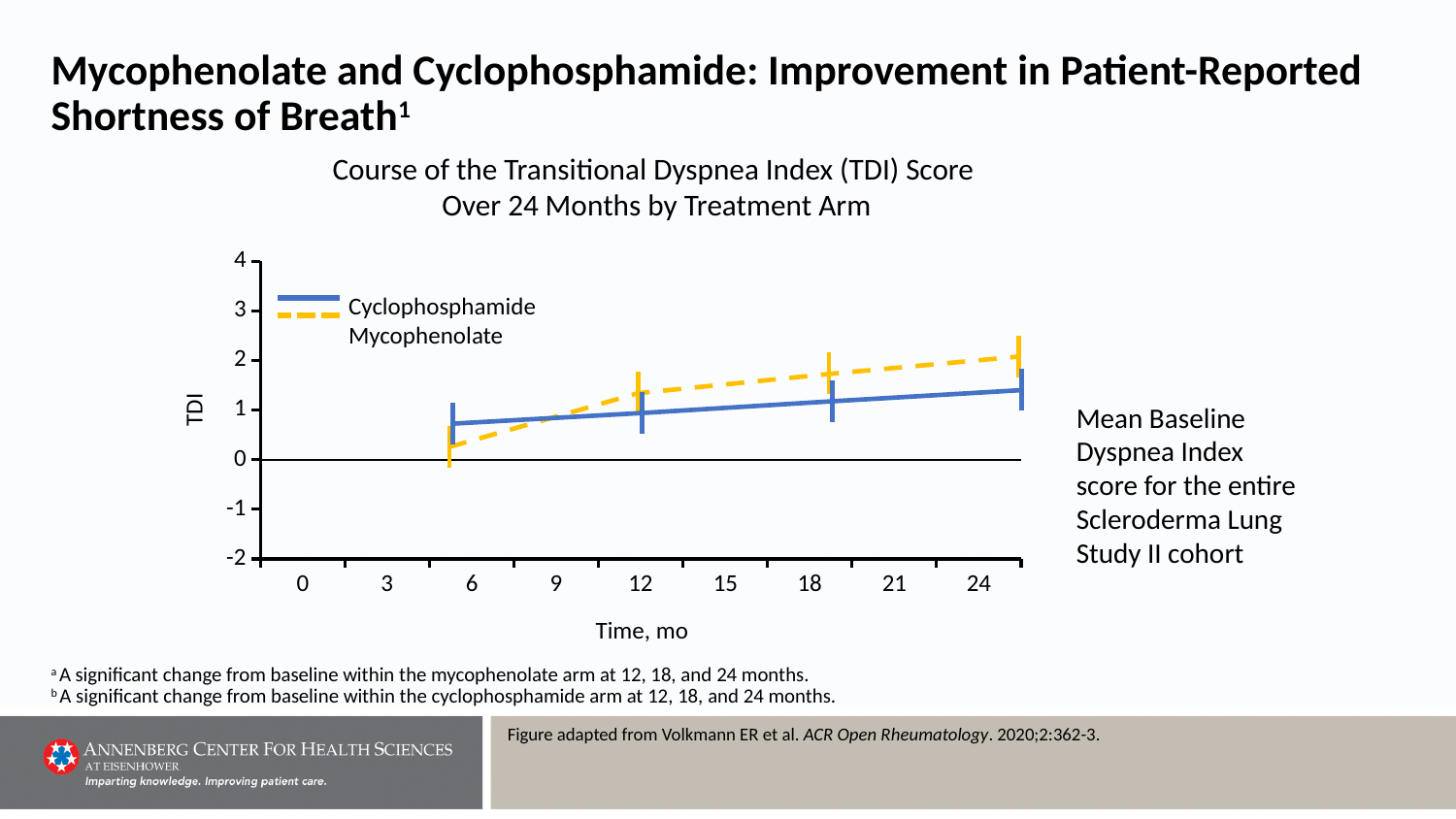
Is the Cyclophosphamide TDI score at 24 months greater or less than 2? less Does the Cyclophosphamide TDI score rise or fall over the 24 months? Rise Is the Mycophenolate TDI score at 24 months greater or less than 1? greater Which two treatment arms are listed in the legend? Cyclophosphamide and Mycophenolate What kind of chart is shown on the slide? Line chart Does the Mycophenolate TDI score rise or fall over the 24 months? Rise Is the Mycophenolate TDI score at the first time point (around 6 months) greater or less than 1? less How many series does the legend list? 2 At 24 months, which arm has the higher TDI score, Cyclophosphamide or Mycophenolate? Mycophenolate How many data points are plotted for each treatment arm? 4 What is the label of the y axis? TDI